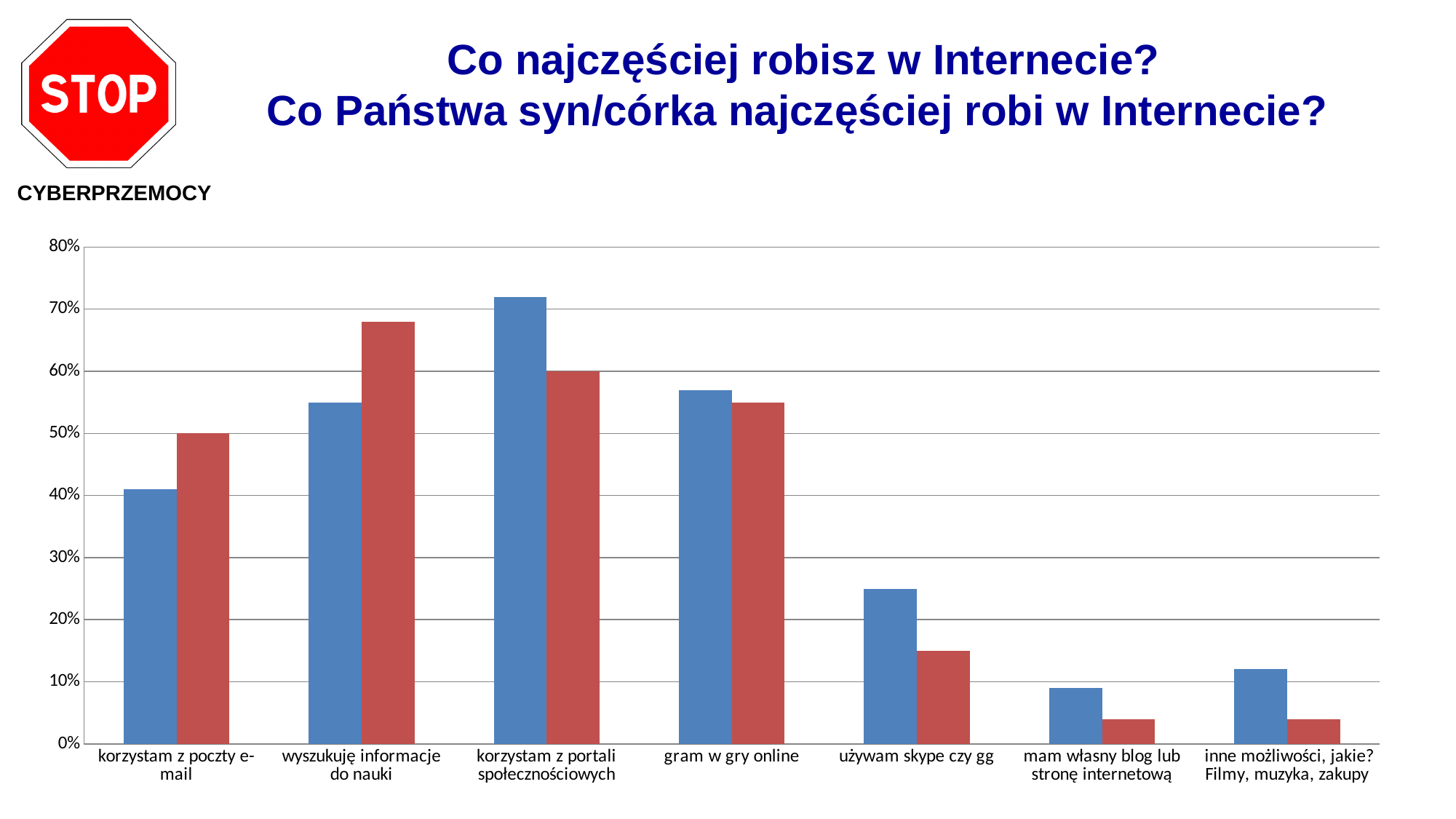
What two colours are used for the bars in the chart? blue and red Is the red bar for 'używam skype czy gg' greater or less than 20%? less Which category has the highest blue bar? korzystam z portali społecznościowych Which category has the highest red bar? wyszukuję informacje do nauki For 'korzystam z poczty e-mail', which bar is larger, the blue one or the red one? the red one Is the blue bar for 'gram w gry online' greater or less than 50%? greater Is the blue bar for 'używam skype czy gg' greater or less than 20%? greater For 'korzystam z portali społecznościowych', which bar is larger, the blue one or the red one? the blue one What kind of chart is shown on the slide? bar chart How many categories are shown along the x axis of the chart? 7 What value does the red bar for 'korzystam z poczty e-mail' reach? 50% Which category has the lowest blue bar? mam własny blog lub stronę internetową